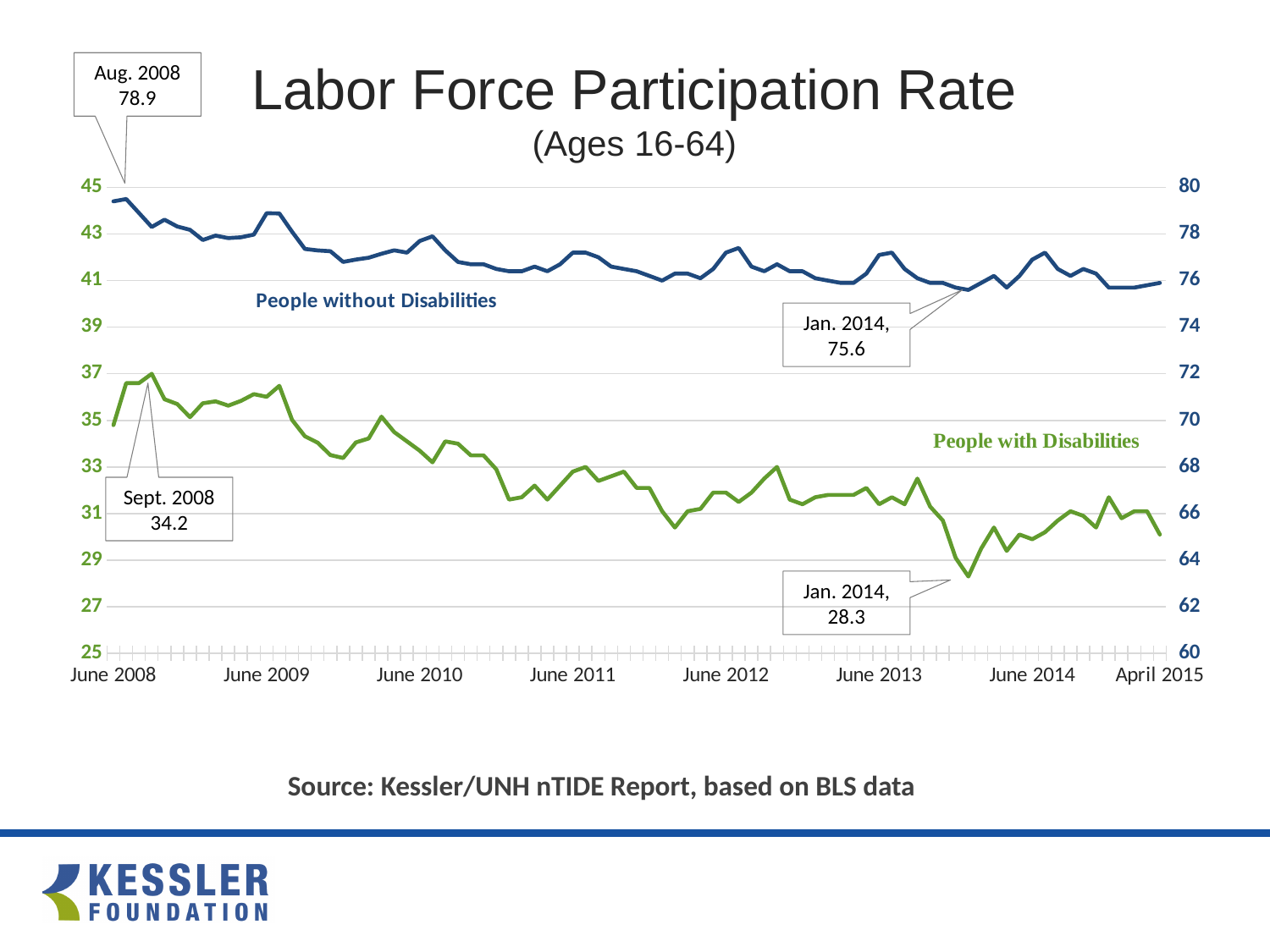
By how much did the rate for People without Disabilities fall from Aug. 2008 to Jan. 2014? 3.3 What is the labor force participation rate for People without Disabilities in Jan. 2014? 75.6 Which is larger for People with Disabilities: the Sept. 2008 value or the Jan. 2014 value? Sept. 2008 What is the labor force participation rate for People with Disabilities in Jan. 2014? 28.3 By how much did the rate for People with Disabilities fall from Sept. 2008 to Jan. 2014? 5.9 Is the value for People without Disabilities in April 2015 greater or less than 78? less Does the rate for People with Disabilities generally rise or fall from June 2008 to April 2015? Fall How many data series are plotted on the chart? 2 What is the labor force participation rate for People with Disabilities in Sept. 2008? 34.2 What is the labor force participation rate for People without Disabilities in Aug. 2008? 78.9 What is the title of the chart? Labor Force Participation Rate (Ages 16-64) What kind of chart is shown on the slide? Line chart